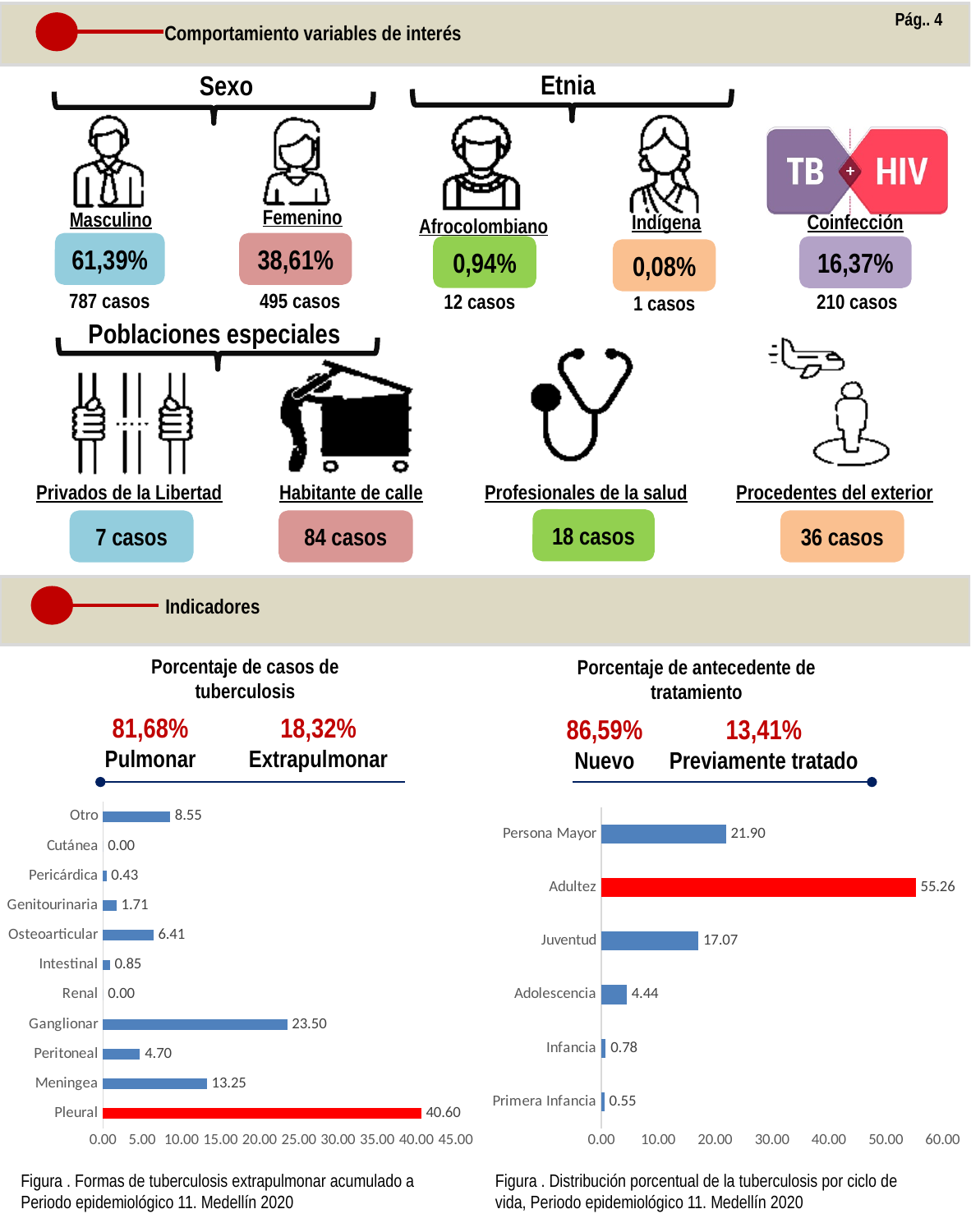
In the right chart (Distribución porcentual de la tuberculosis por ciclo de vida), what is the difference between the values for Persona Mayor and Juventud? 4.83 In the left chart (Formas de tuberculosis extrapulmonar), what is the value for Ganglionar? 23.50 In the right chart (Distribución porcentual de la tuberculosis por ciclo de vida), how many categories are shown? 6 In the left chart (Formas de tuberculosis extrapulmonar), which category has the highest value? Pleural In the left chart (Formas de tuberculosis extrapulmonar), how many categories are shown? 11 In the left chart (Formas de tuberculosis extrapulmonar), what is the difference between the values for Pleural and Ganglionar? 17.10 In the left chart (Formas de tuberculosis extrapulmonar), which categories have a value of 0.00? Cutánea and Renal What type of chart is the right chart (Distribución porcentual de la tuberculosis por ciclo de vida)? Bar chart In the left chart (Formas de tuberculosis extrapulmonar), what is the value for Meningea? 13.25 In the right chart (Distribución porcentual de la tuberculosis por ciclo de vida), which category has the lowest value? Primera Infancia In the left chart (Formas de tuberculosis extrapulmonar), which is larger, Osteoarticular or Peritoneal? Osteoarticular In the right chart (Distribución porcentual de la tuberculosis por ciclo de vida), what is the value for Adultez? 55.26